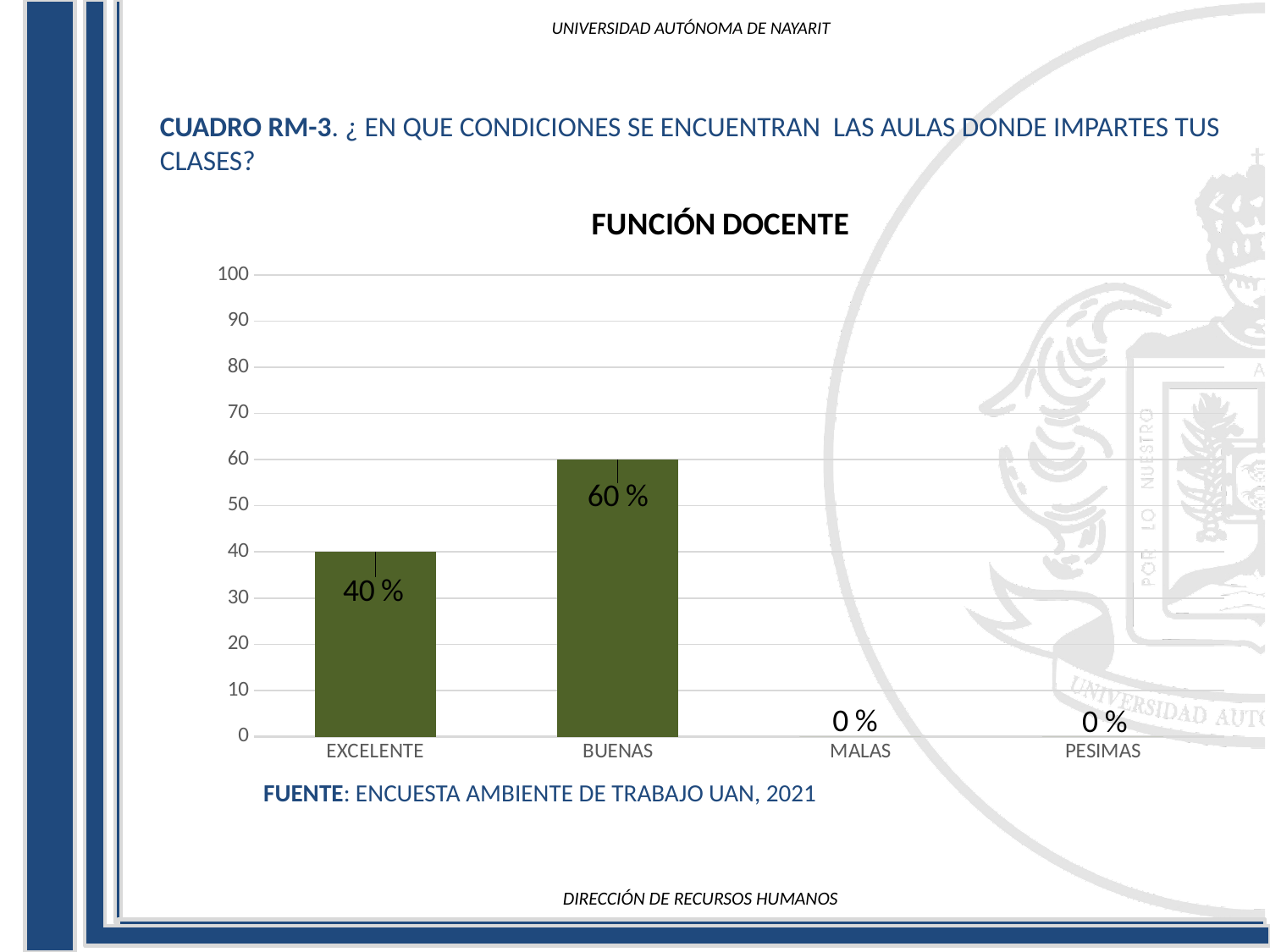
What is the difference between the values for BUENAS and EXCELENTE? 20 % How many categories are shown on the x axis? 4 What is the value for PESIMAS? 0 % Which category has the highest value? BUENAS Which is larger, the value for EXCELENTE or the value for BUENAS? BUENAS What kind of chart is shown? bar chart What is the value for EXCELENTE? 40 % Is the value for EXCELENTE greater or less than 50? less What is the title of the chart? FUNCIÓN DOCENTE What is the value for MALAS? 0 % Is the value for BUENAS greater or less than 50? greater What is the value for BUENAS? 60 %